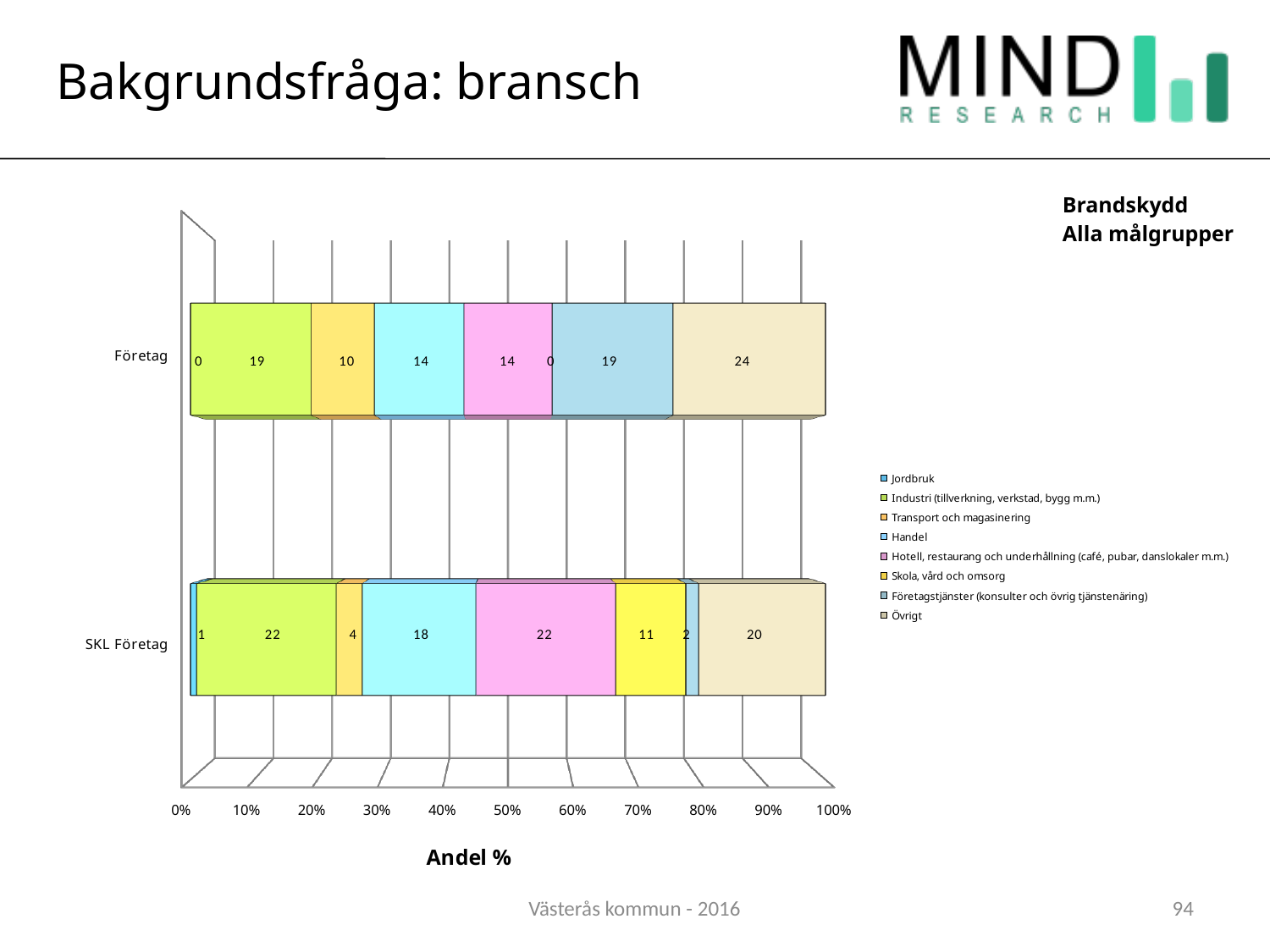
How many categories are plotted on the y axis? 2 What is the difference between the Industri values for SKL Företag and Företag? 3 What is the value for Skola, vård och omsorg in the SKL Företag bar? 11 Which is larger: Företagstjänster for Företag or Företagstjänster for SKL Företag? Företag What is the total of the SKL Företag stacked bar? 100 What is the value for Handel in the SKL Företag bar? 18 Which segment is the largest in the Företag bar? Övrigt What is the label of the x axis? Andel % What is the value for Transport och magasinering in the Företag bar? 10 What kind of chart is shown on the slide? Stacked bar chart What is the value for Övrigt in the Företag bar? 24 How many series does the legend list? 8